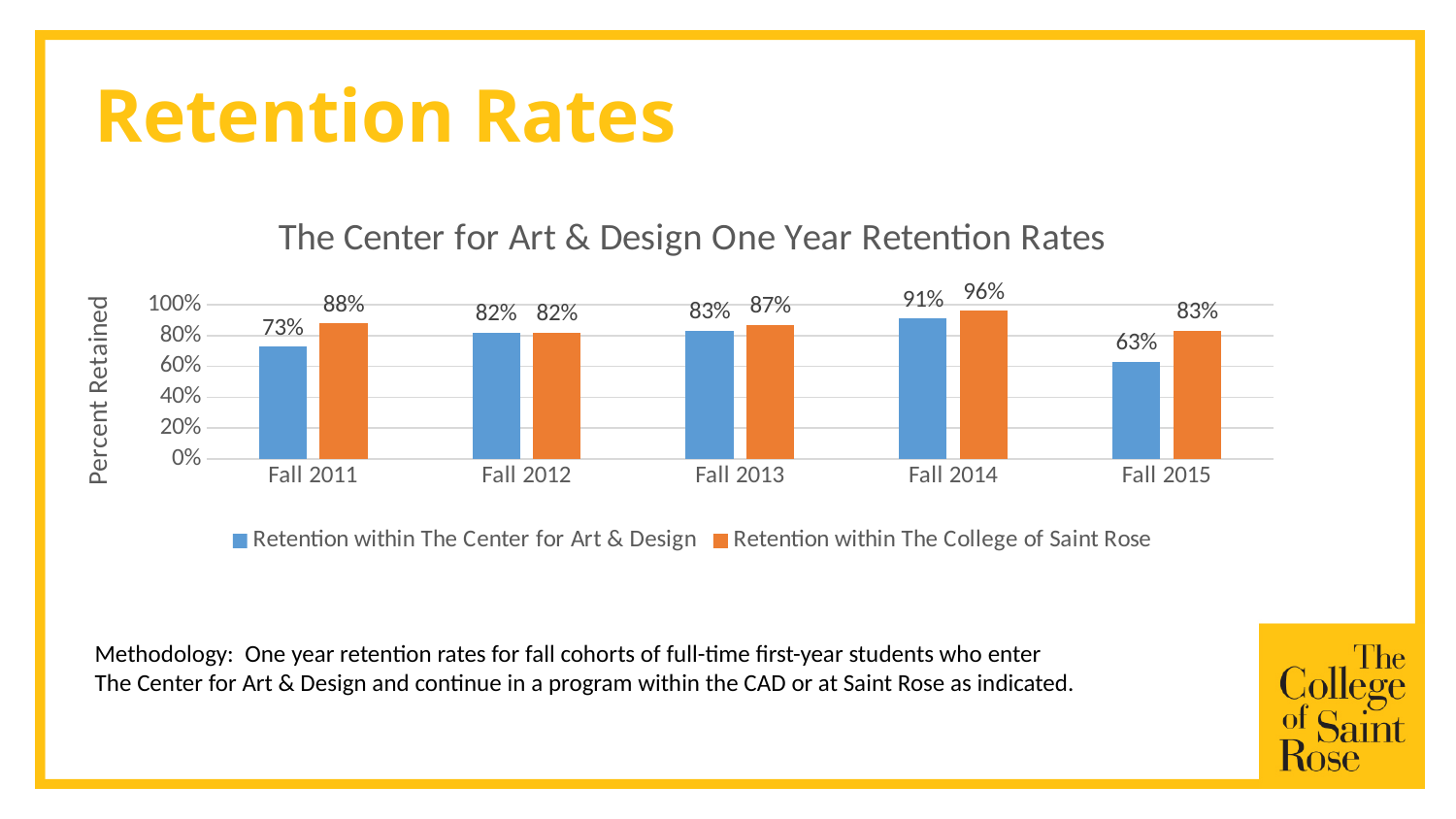
Which fall cohort has the highest retention rate within The Center for Art & Design? Fall 2014 What kind of chart is shown on the slide? Bar chart What is the retention rate within The Center for Art & Design for Fall 2011? 73% What is the retention rate within The College of Saint Rose for Fall 2014? 96% How many fall cohorts are shown on the x axis? 5 What is the retention rate within The Center for Art & Design for Fall 2015? 63% What is the title of the chart? The Center for Art & Design One Year Retention Rates What is the difference between the retention rate within The College of Saint Rose and within The Center for Art & Design for Fall 2015? 20% Is the retention rate within The Center for Art & Design for Fall 2015 greater or less than 80%? less How many series does the legend list? 2 Which fall cohort has the lowest retention rate within The College of Saint Rose? Fall 2012 For Fall 2013, which is larger: retention within The Center for Art & Design or retention within The College of Saint Rose? Retention within The College of Saint Rose